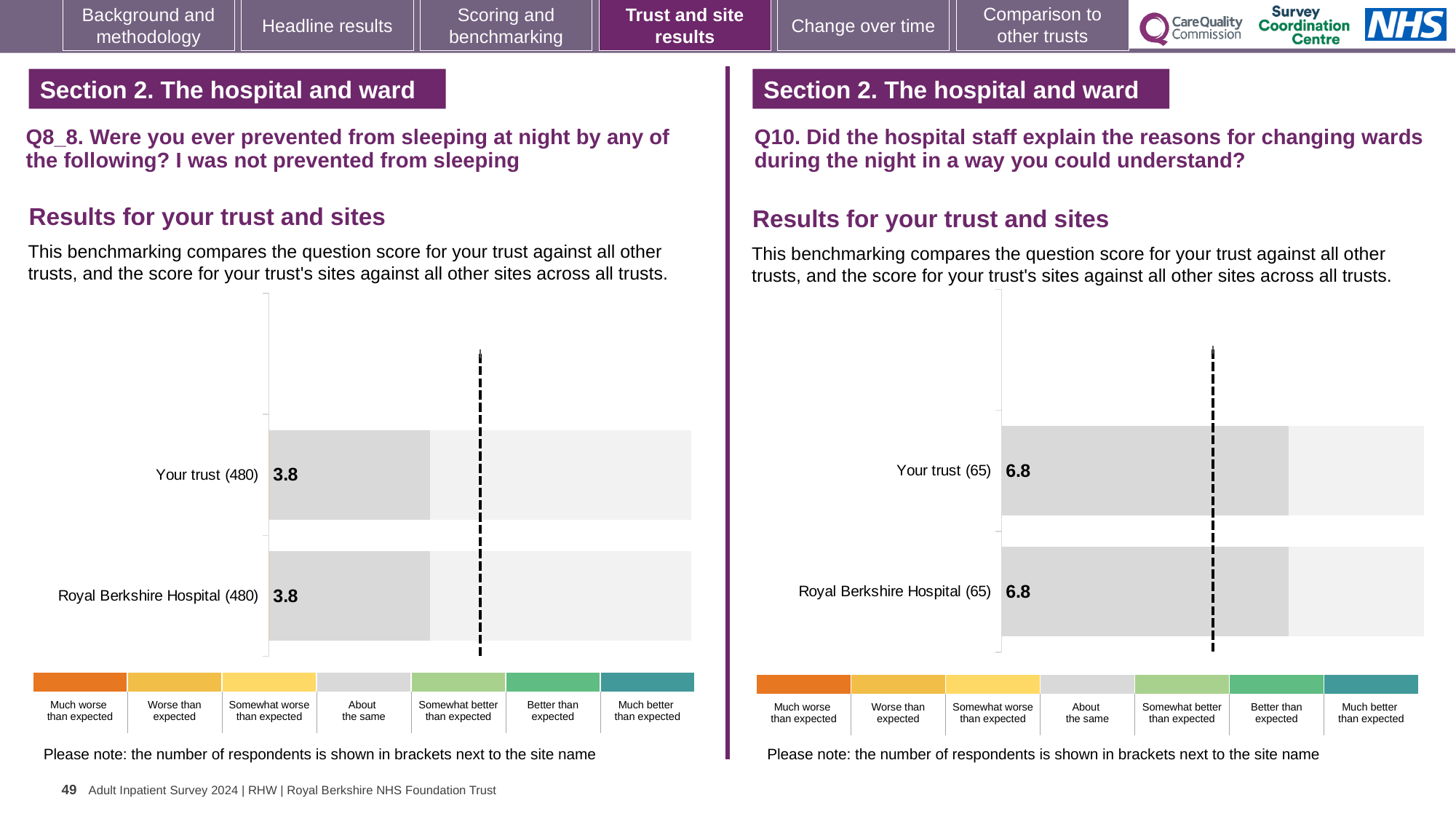
On the Q10 chart (right), what is the difference between the score for Your trust and the score for Royal Berkshire Hospital? 0 On the Q8_8 chart (left), what is the difference between the score for Your trust and the score for Royal Berkshire Hospital? 0 On the Q8_8 chart (left), what is the score for Royal Berkshire Hospital? 3.8 On the Q10 chart (right), what is the score for Royal Berkshire Hospital? 6.8 How many categories does the colour key below the Q8_8 chart (left) list? 7 On the Q8_8 chart (left), what is the score for Your trust? 3.8 On the Q10 chart (right), how many respondents are shown in brackets for Royal Berkshire Hospital? 65 On the Q8_8 chart (left), how many respondents are shown in brackets for Your trust? 480 On the Q10 chart (right), what is the score for Your trust? 6.8 How many bars are plotted on the Q8_8 chart (left)? 2 How many bars are plotted on the Q10 chart (right)? 2 What kind of chart is the Q10 chart (right)? Bar chart